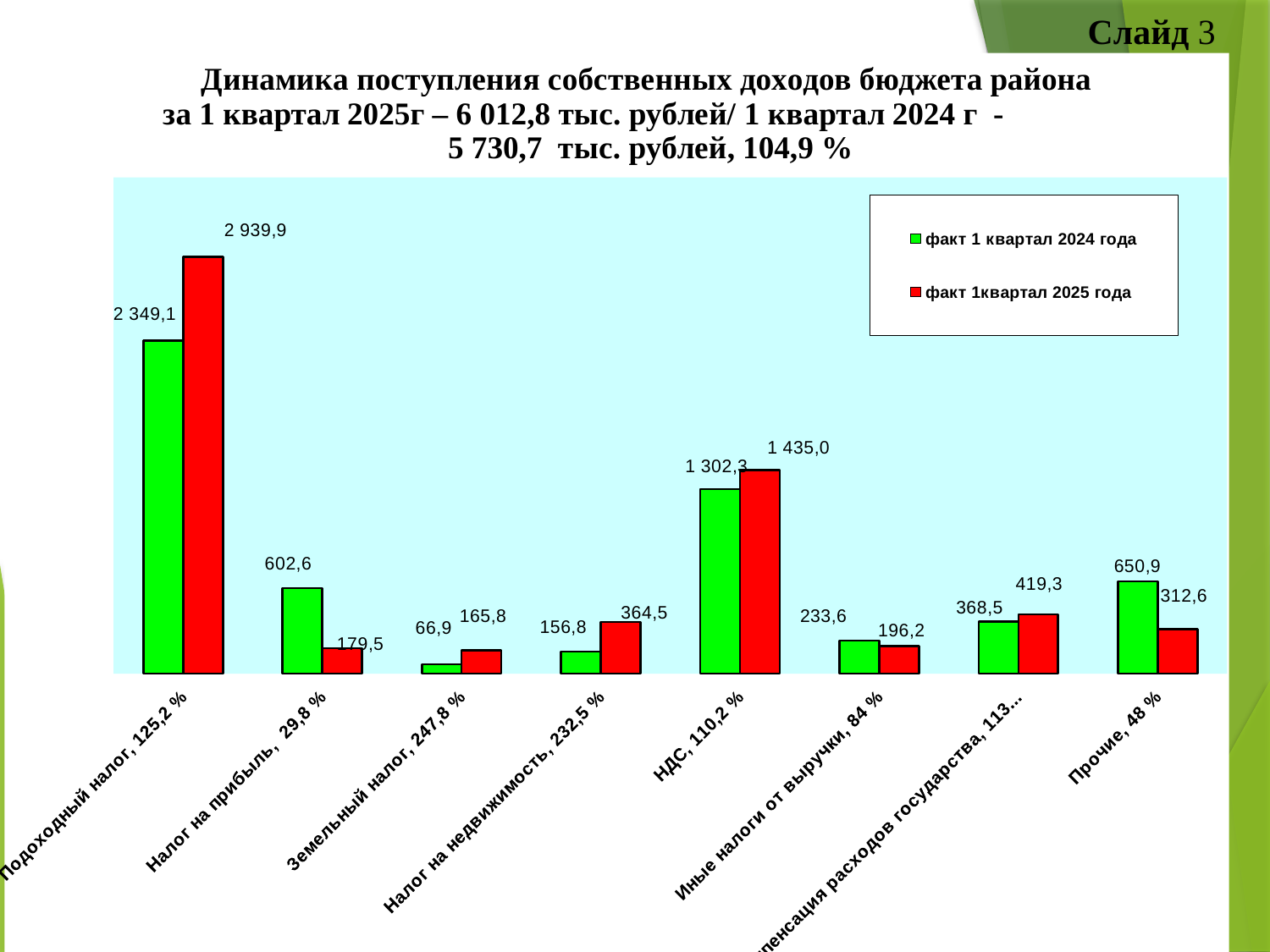
How many series does the legend list? 2 What is the value of 'факт 1 квартал 2024 года' for 'Подоходный налог'? 2 349,1 For 'Налог на прибыль', which is larger: the 2024 value or the 2025 value? 2024 value (602,6) Which category has the lowest value for 'факт 1 квартал 2024 года'? Земельный налог How many categories are shown on the x axis of the chart? 8 What is the value of 'факт 1квартал 2025 года' for 'Прочие'? 312,6 What is the difference between the 2025 and 2024 values for 'Подоходный налог'? 590,8 What type of chart is shown on the slide? bar chart Which category has the highest value for 'факт 1квартал 2025 года'? Подоходный налог What is the value of 'факт 1 квартал 2024 года' for 'Земельный налог'? 66,9 What is the value of 'факт 1квартал 2025 года' for 'НДС'? 1 435,0 Which colour represents 'факт 1квартал 2025 года' in the chart? red